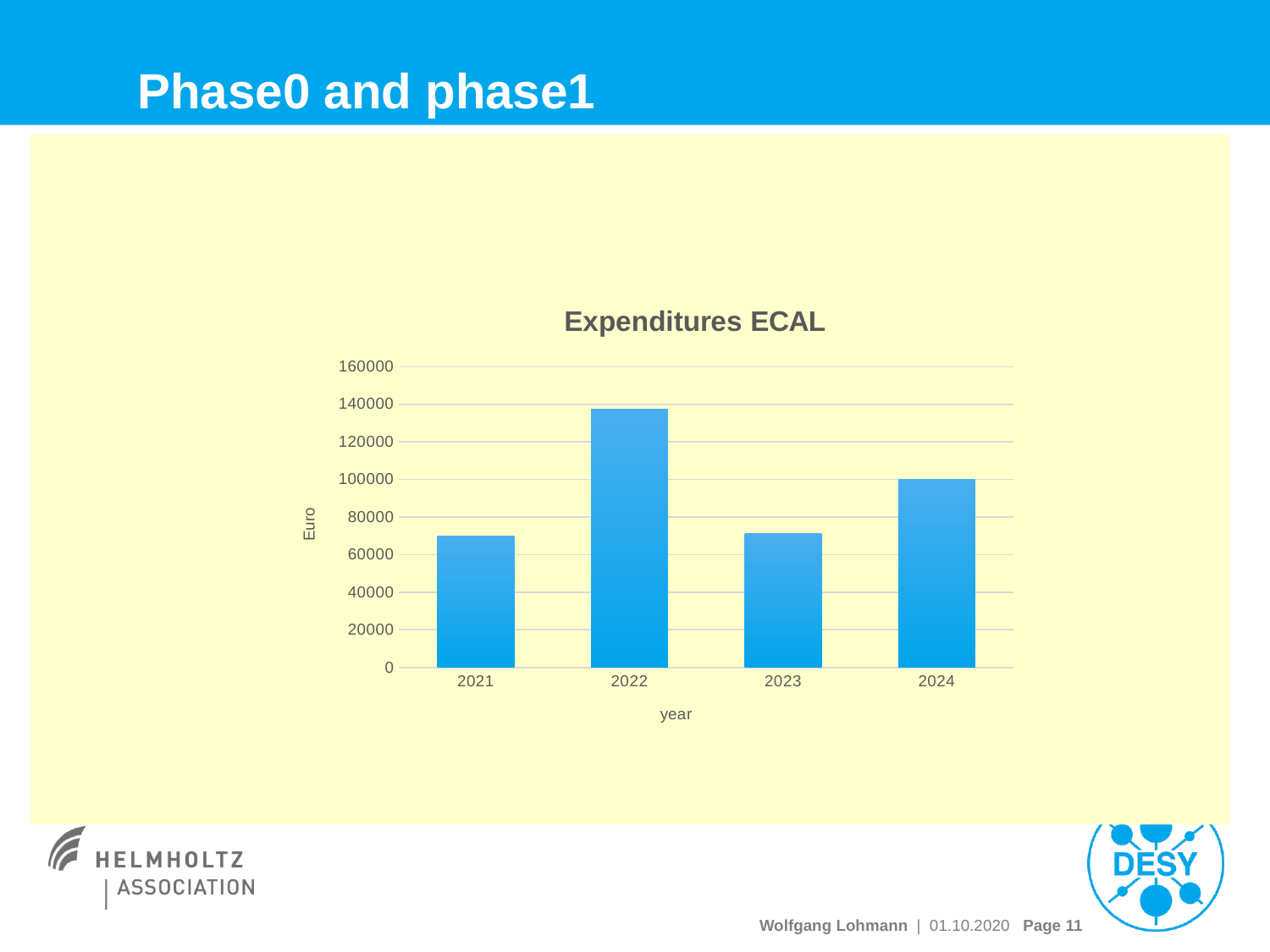
Is the value for 2024 greater or less than 80000? greater What is the title of the chart? Expenditures ECAL Is the value for 2023 greater or less than 60000? greater Which is larger, the value for 2022 or the value for 2024? 2022 What is the label of the vertical axis of the chart? Euro Is the value for 2022 greater or less than 120000? greater How many years are shown on the x axis of the chart? 4 Which is larger, the value for 2024 or the value for 2021? 2024 Which year has the highest expenditure in the chart? 2022 What kind of chart is shown on the slide? bar chart Does the expenditure rise or fall from 2022 to 2023? fall